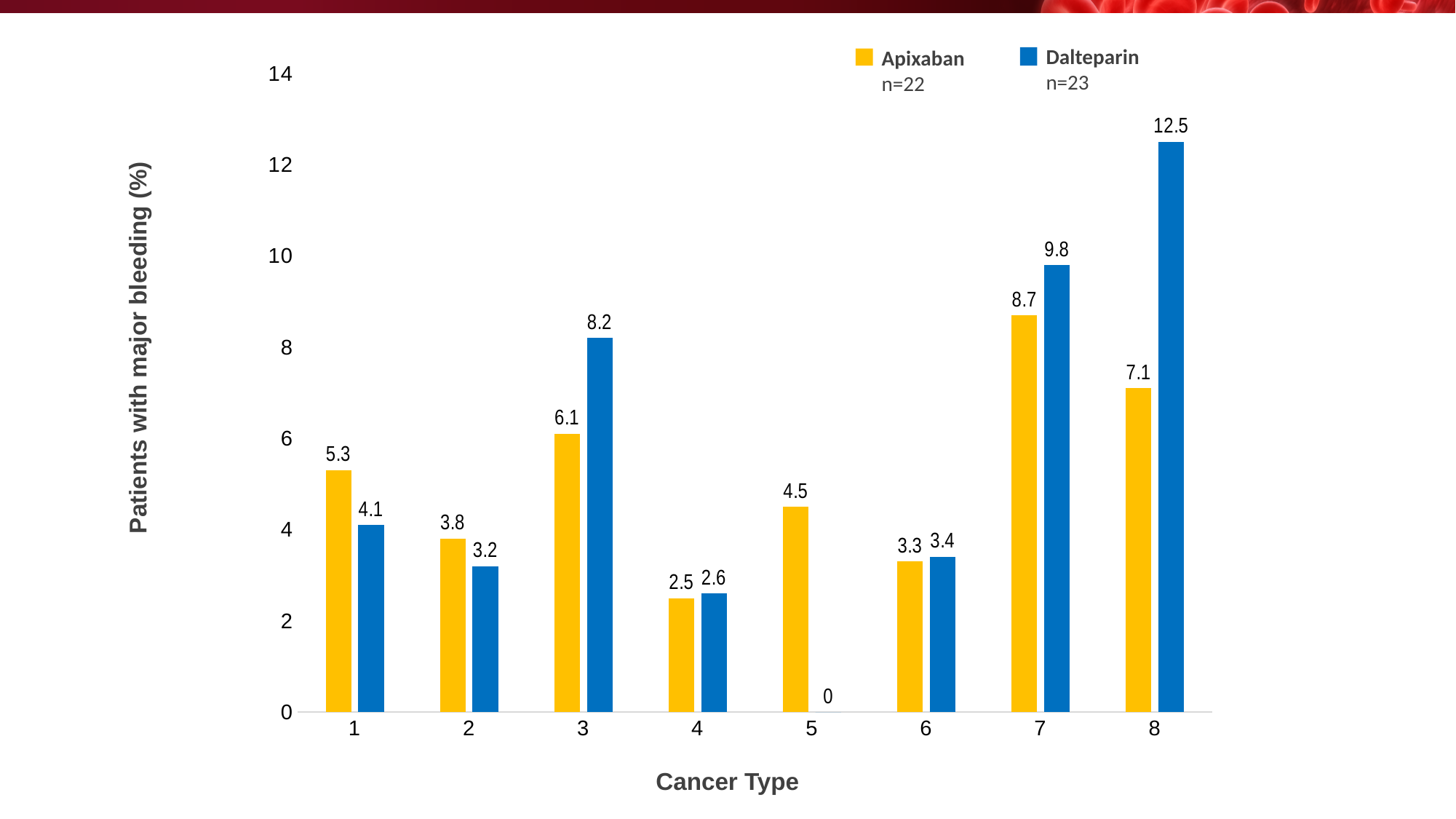
What is the label of the y axis? Patients with major bleeding (%) Is the Dalteparin value for cancer type 7 greater or less than 8? greater What is the Dalteparin value for cancer type 8? 12.5 How many series does the legend list? 2 What is the Dalteparin value for cancer type 5? 0 Which cancer type has the highest Apixaban value? 7 What kind of chart is shown on the slide? Bar chart What is the Apixaban value for cancer type 3? 6.1 How many cancer types are shown on the x axis? 8 Which cancer type has the lowest Apixaban value? 4 What is the difference between the Dalteparin and Apixaban values for cancer type 8? 5.4 For cancer type 1, which series has the larger value, Apixaban or Dalteparin? Apixaban